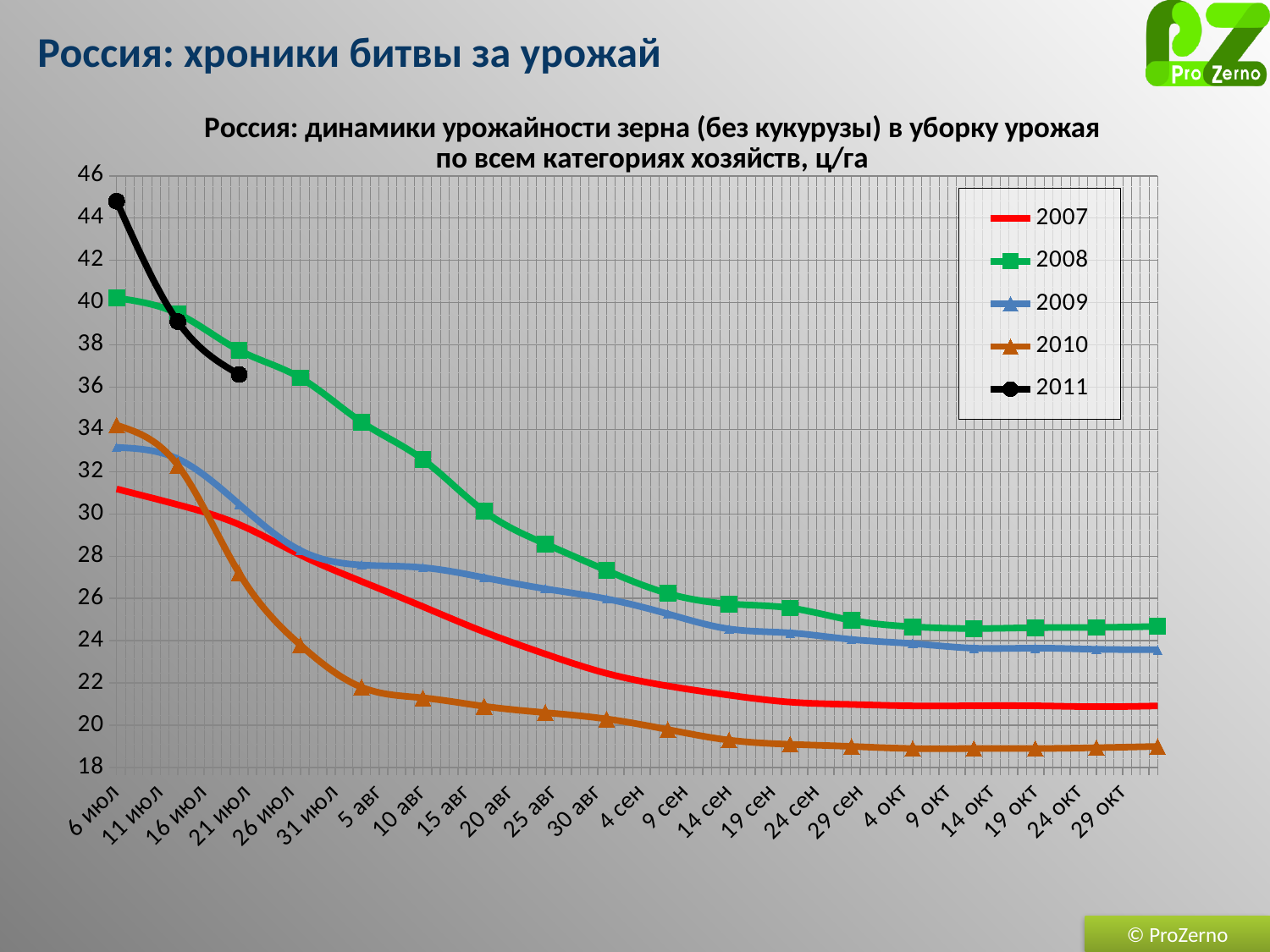
Which series has the highest value at 6 июл? 2011 How many date labels are shown on the x axis? 24 How many series does the legend list? 5 What kind of chart is shown on the slide? line chart Which years are listed in the legend? 2007, 2008, 2009, 2010, 2011 Is the value for 2010 at 29 окт greater or less than 20? less Which series is drawn in black? 2011 Is the value for 2008 at 6 июл greater or less than 38? greater Which series has the lowest value at 29 окт? 2010 Do the values for the 2008 series rise or fall along the x axis? fall At 29 окт, which is larger: the value for 2008 or the value for 2009? 2008 Is the value for 2011 at 6 июл greater or less than 42? greater